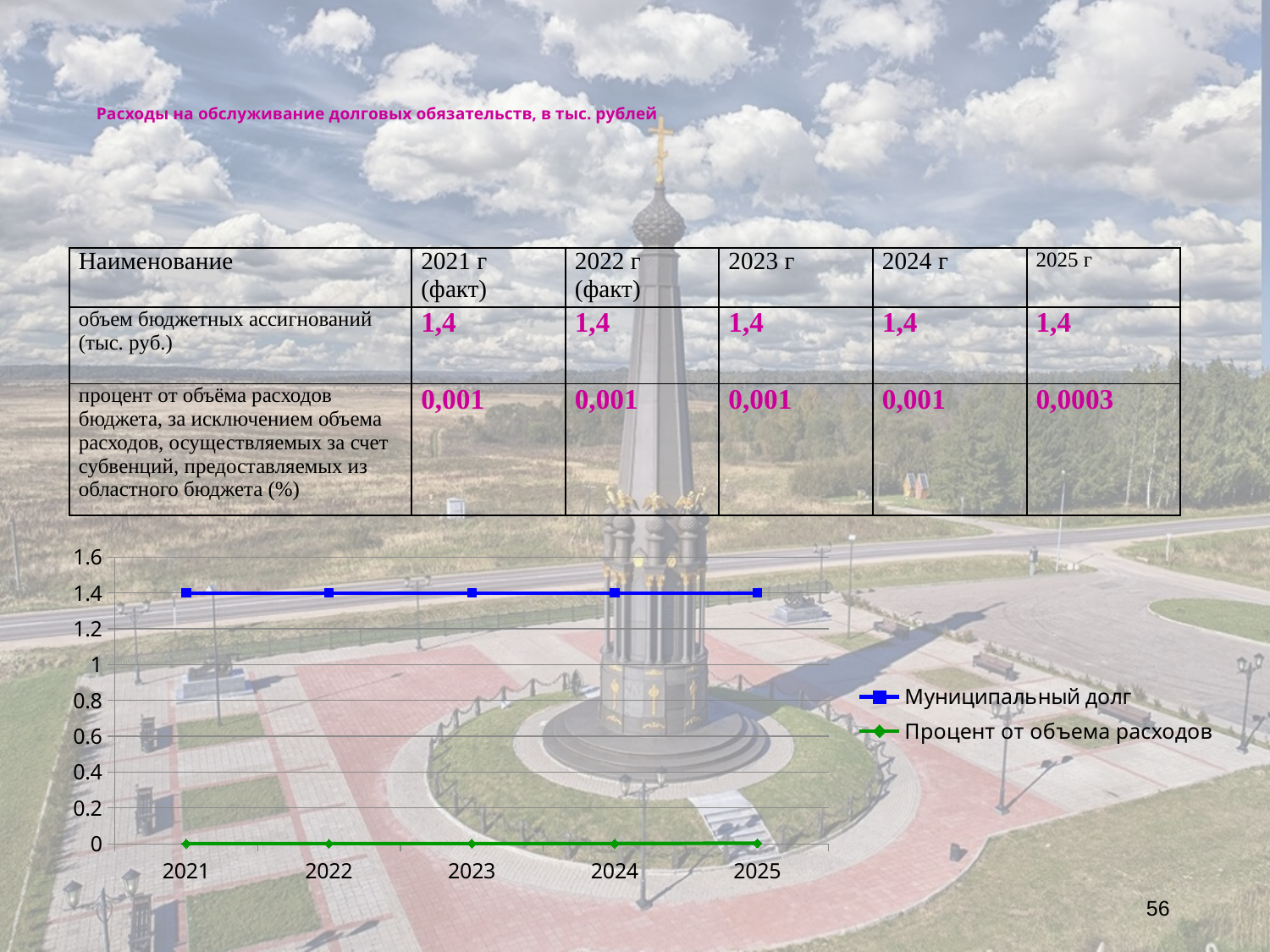
What is the first year shown on the x axis of the chart? 2021 What colour is the line for Муниципальный долг? blue Is the value for Муниципальный долг in 2022 greater or less than 1? greater How many years are shown on the x axis of the chart? 5 What kind of chart is shown on the slide? line chart What is the value of Муниципальный долг in 2025 on the chart? 1.4 What is the value of Муниципальный долг in 2021 on the chart? 1.4 What is the highest value shown on the y axis of the chart? 1.6 Which series is higher in 2023, Муниципальный долг or Процент от объема расходов? Муниципальный долг Is the value for Процент от объема расходов in 2024 greater or less than 0.2? less Does the Муниципальный долг line rise, fall or stay flat from 2021 to 2025? stays flat How many series does the chart legend list? 2